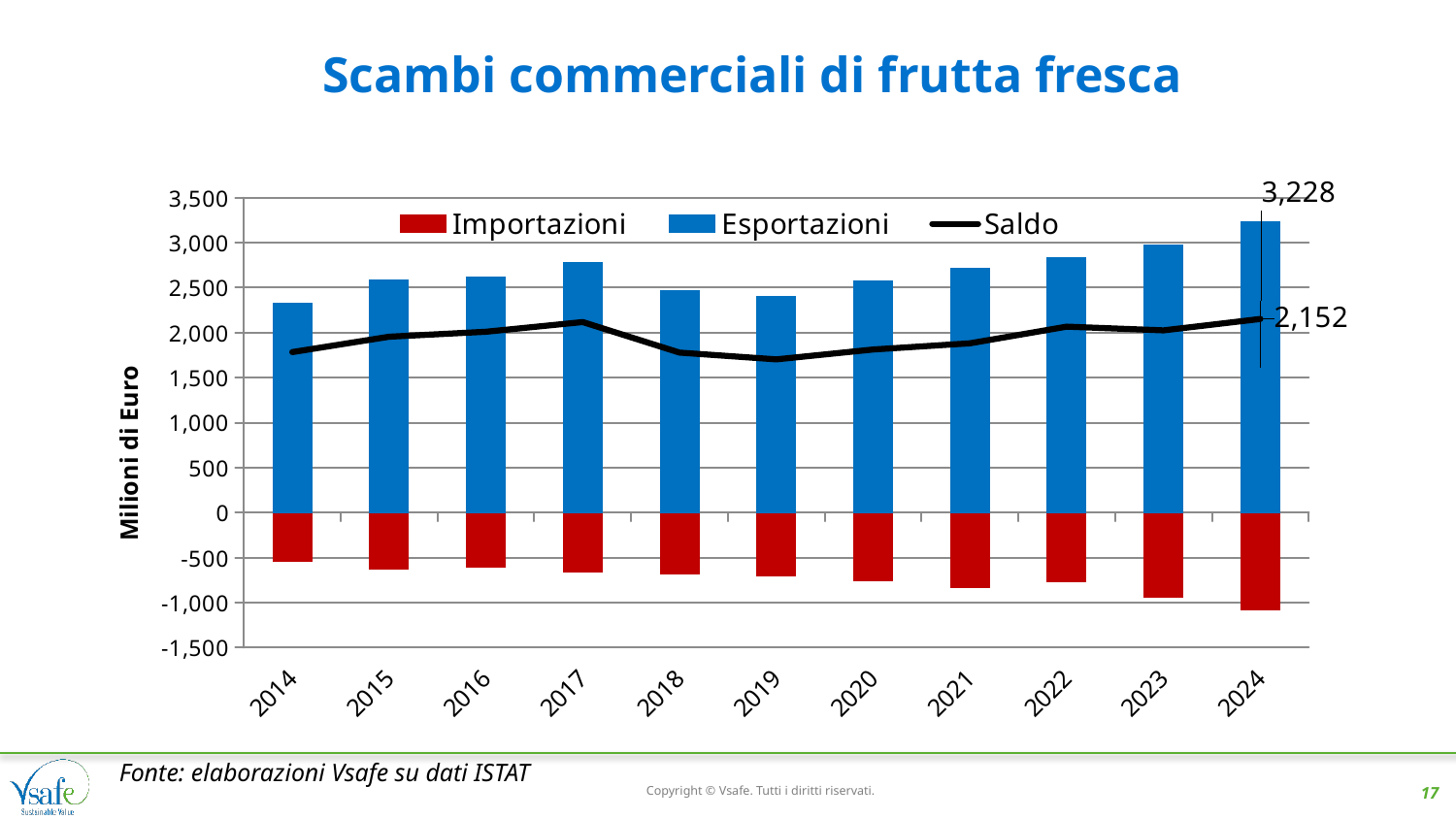
Is the value of Esportazioni in 2014 greater or less than 2,500? less What is the value of Esportazioni in 2024? 3,228 What is the difference between Esportazioni and Saldo in 2024? 1,076 How many years are shown on the x axis? 11 In which year do Importazioni reach their largest magnitude (the longest red bar)? 2024 What is the value of Saldo in 2024? 2,152 Is the value of Saldo in 2019 greater or less than 2,000? less How many series does the legend list? 3 In which year is Esportazioni highest? 2024 What is the label of the vertical axis? Milioni di Euro Is the value of Esportazioni in 2017 greater or less than 2,500? greater What kind of chart is shown? Bar chart with a line